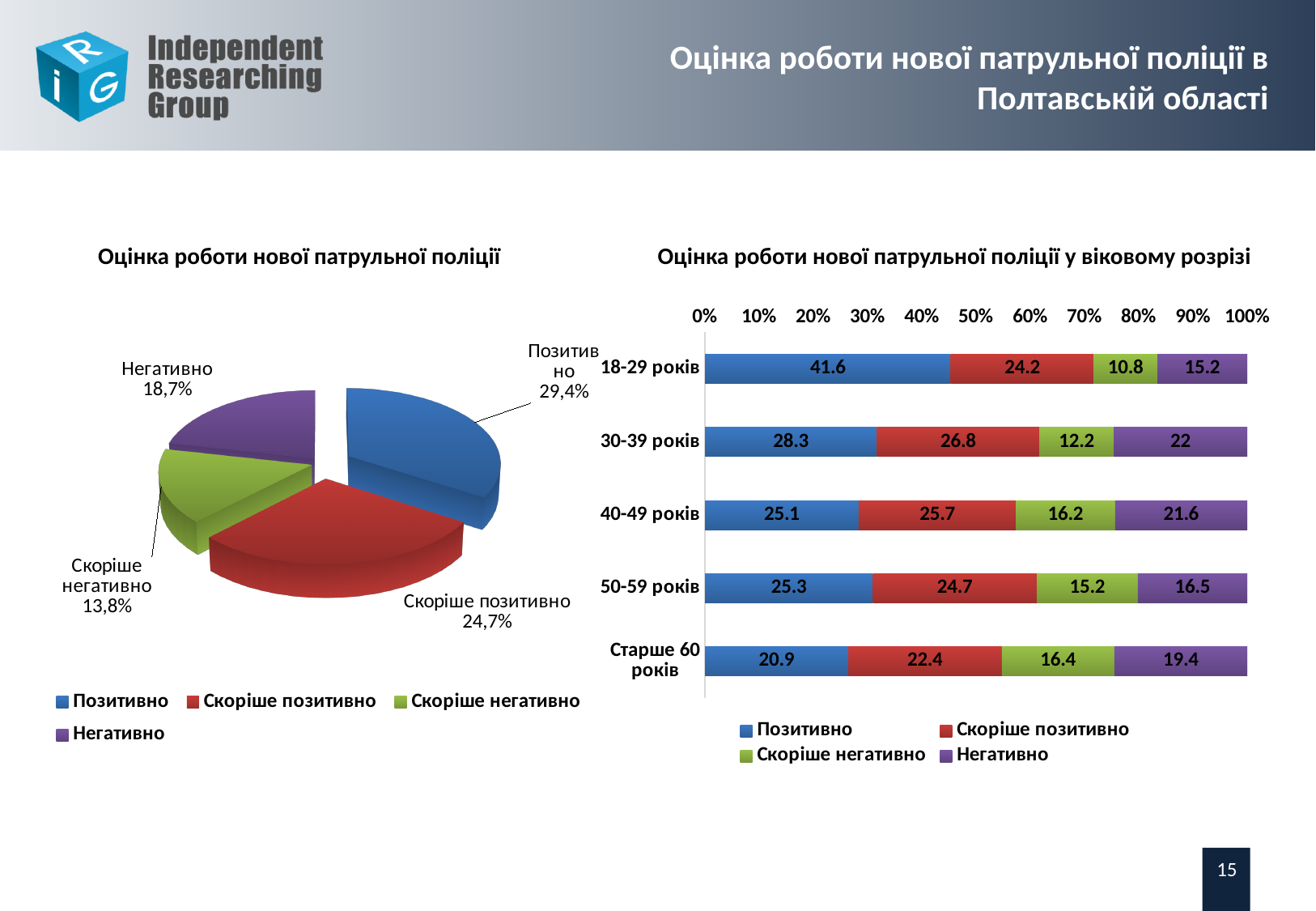
In the chart 'Оцінка роботи нової патрульної поліції у віковому розрізі', which age group has the highest 'Позитивно' value? 18-29 років In the chart 'Оцінка роботи нової патрульної поліції у віковому розрізі', which age group has the lowest 'Позитивно' value? Старше 60 років What type of chart is 'Оцінка роботи нової патрульної поліції у віковому розрізі'? Stacked bar chart In the pie chart 'Оцінка роботи нової патрульної поліції', what share is labelled for 'Позитивно'? 29,4% In the chart 'Оцінка роботи нової патрульної поліції у віковому розрізі', how many series does the legend list? 4 In the chart 'Оцінка роботи нової патрульної поліції у віковому розрізі', what is the value of 'Негативно' for '30-39 років'? 22 In the pie chart 'Оцінка роботи нової патрульної поліції', which category has the largest slice? Позитивно In the chart 'Оцінка роботи нової патрульної поліції у віковому розрізі', what is the difference between the 'Позитивно' values for '18-29 років' and '30-39 років'? 13.3 In the pie chart 'Оцінка роботи нової патрульної поліції', which category has the smallest slice? Скоріше негативно In the pie chart 'Оцінка роботи нової патрульної поліції', how many slices are there? 4 In the chart 'Оцінка роботи нової патрульної поліції у віковому розрізі', which is larger for '40-49 років': 'Скоріше негативно' or 'Негативно'? Негативно In the chart 'Оцінка роботи нової патрульної поліції у віковому розрізі', what is the value of 'Позитивно' for '18-29 років'? 41.6